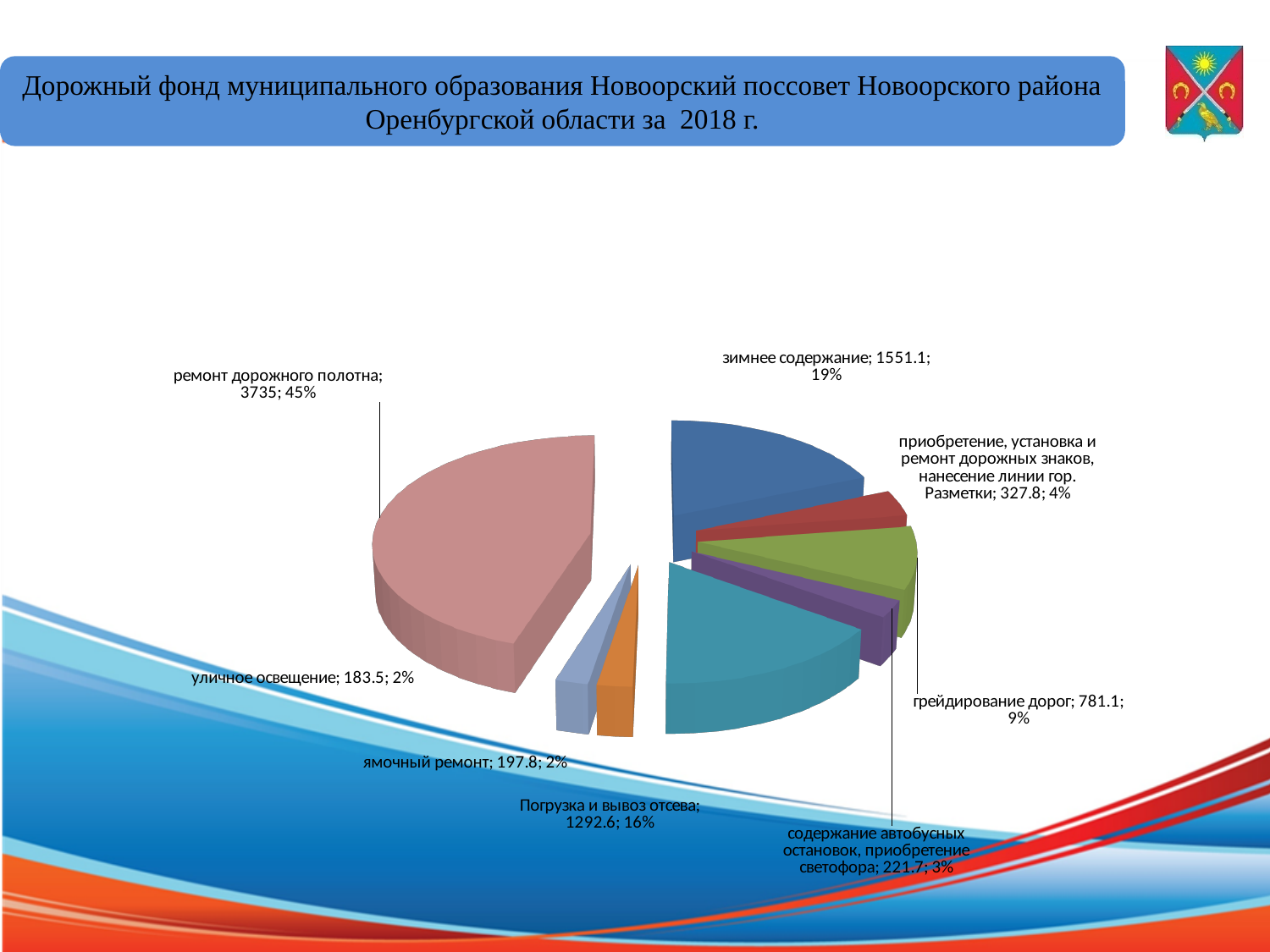
What is the value for грейдирование дорог? 781.1 What is the value for ремонт дорожного полотна? 3735 Which category has the smallest slice of the pie? уличное освещение What is the value for зимнее содержание? 1551.1 What share of the pie does ремонт дорожного полотна represent? 45% What kind of chart is shown on the slide? pie chart Which category has the largest slice of the pie? ремонт дорожного полотна How many slices does the pie chart have? 8 What is the value for Погрузка и вывоз отсева? 1292.6 Which is larger, the value for зимнее содержание or the value for Погрузка и вывоз отсева? зимнее содержание What is the difference between the values for ремонт дорожного полотна and зимнее содержание? 2183.9 What share of the pie does содержание автобусных остановок, приобретение светофора represent? 3%